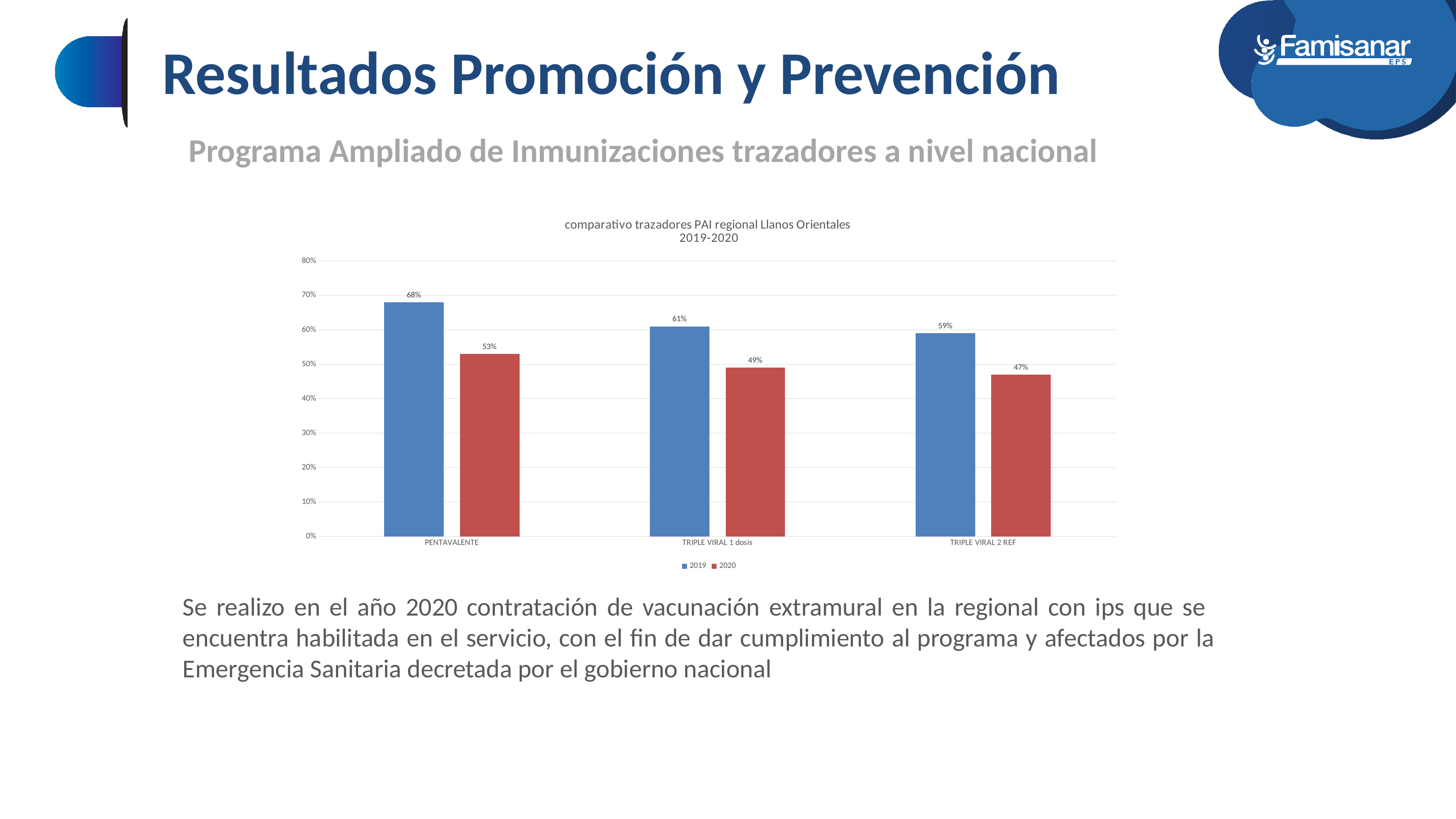
What is the 2020 value for TRIPLE VIRAL 1 dosis? 49% What is the 2019 value for PENTAVALENTE? 68% Which category has the lowest 2020 value? TRIPLE VIRAL 2 REF What is the difference between the 2019 and 2020 values for TRIPLE VIRAL 2 REF? 12% Which category has the highest 2019 value? PENTAVALENTE What is the 2020 value for TRIPLE VIRAL 2 REF? 47% What is the title of the chart? comparativo trazadores PAI regional Llanos Orientales 2019-2020 Which is larger for TRIPLE VIRAL 1 dosis, the 2019 value or the 2020 value? 2019 What is the difference between the 2019 and 2020 values for PENTAVALENTE? 15% What kind of chart is shown on the slide? Bar chart How many categories are shown on the x axis? 3 How many series does the legend list? 2